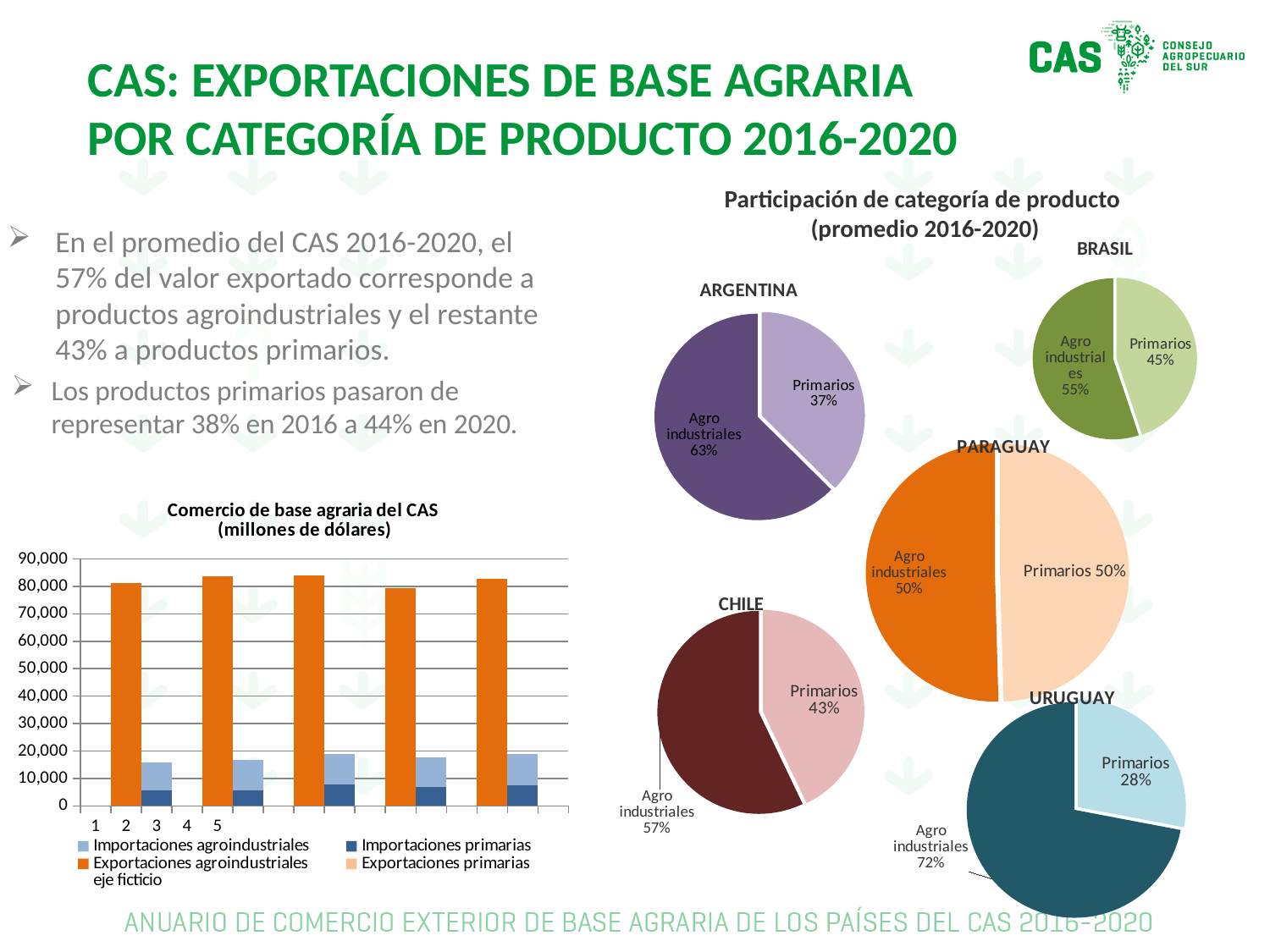
Which is larger: the Agro industriales share in the URUGUAY pie chart or in the ARGENTINA pie chart? Uruguay In the ARGENTINA pie chart, what is the difference in percentage points between the Agro industriales and Primarios shares? 26 percentage points Among the five country pie charts, which country has the lowest Agro industriales share? Paraguay How many entries does the legend of the 'Comercio de base agraria del CAS' chart list? 5 Among the five country pie charts, which country has the highest Agro industriales share? Uruguay In the URUGUAY pie chart, what share is labelled for Primarios? 28% In the BRASIL pie chart, what share is labelled for Agro industriales? 55% In the 'Comercio de base agraria del CAS' chart, is the Exportaciones agroindustriales value for the first group greater or less than 70,000? greater In the ARGENTINA pie chart, what share is labelled for Primarios? 37% In the PARAGUAY pie chart, what share is labelled for Primarios? 50% In the CHILE pie chart, what share is labelled for Agro industriales? 57% What kind of chart is 'Comercio de base agraria del CAS (millones de dólares)'? bar chart